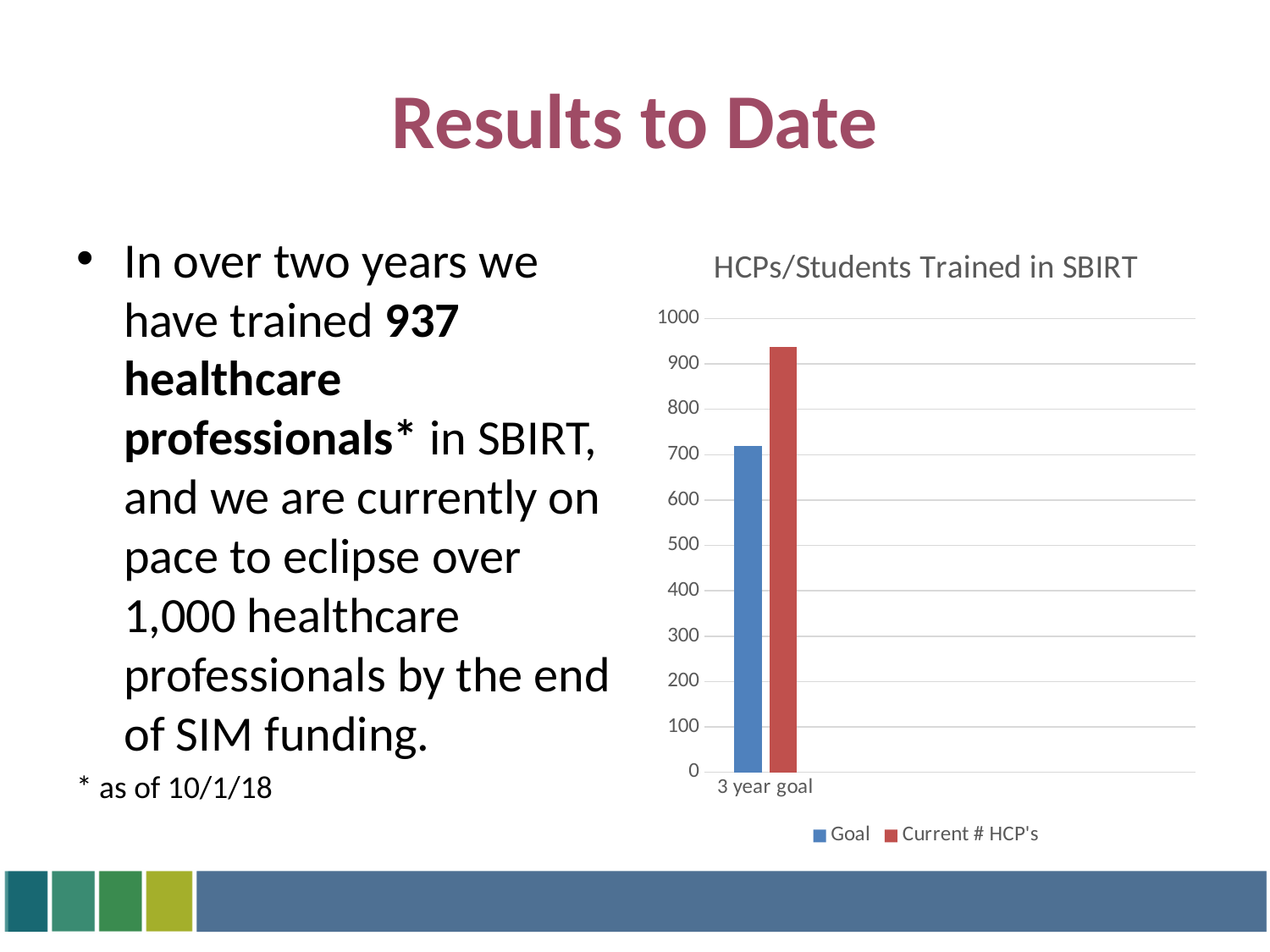
How many series does the chart legend list? 2 What kind of chart is shown on the slide? bar chart Is the value for Current # HCP's greater or less than 1000? less Is the value for Goal greater or less than 800? less What is the title of the chart? HCPs/Students Trained in SBIRT Is the value for Current # HCP's greater or less than 900? greater How many categories are shown on the x axis of the chart? 1 Which series has the lowest value in the chart? Goal What is the category label shown on the x axis of the chart? 3 year goal Which series has the highest value in the chart? Current # HCP's Which series has the taller bar, Goal or Current # HCP's? Current # HCP's